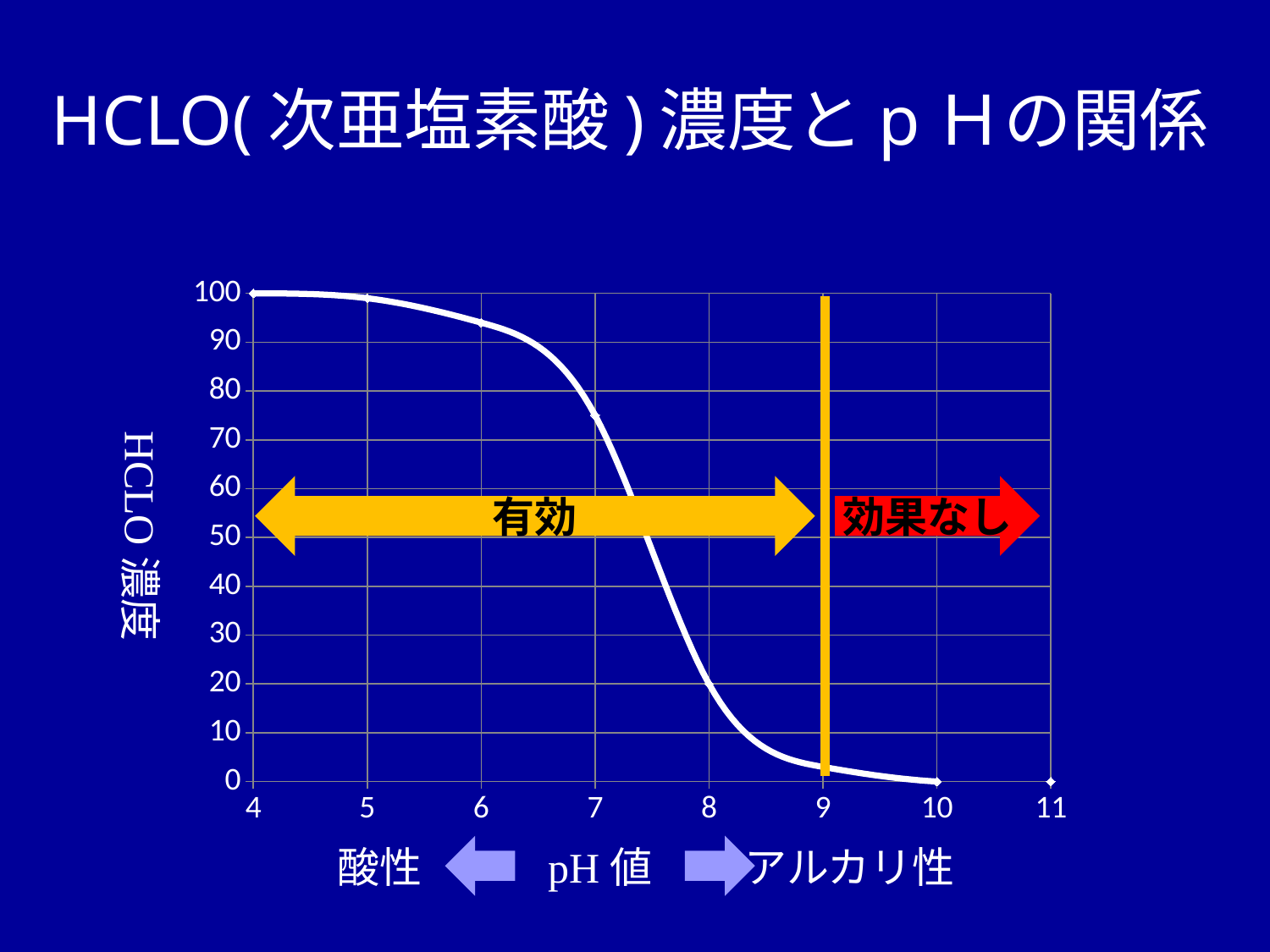
As pH increases along the x axis, does the HCLO concentration rise or fall? fall What kind of chart is shown on the slide? line chart What is the label on the vertical axis of the chart? HCLO 濃度 At which pH value is the vertical orange line separating 有効 from 効果なし drawn? 9 How many pH values are labelled on the x axis? 8 Is the HCLO concentration at pH 5 greater or less than 90? greater Is the HCLO concentration at pH 6 greater or less than 80? greater Which has the higher HCLO concentration, pH 6 or pH 8? pH 6 Is the HCLO concentration at pH 8 greater or less than 50? less What is the HCLO concentration at pH 4? 100